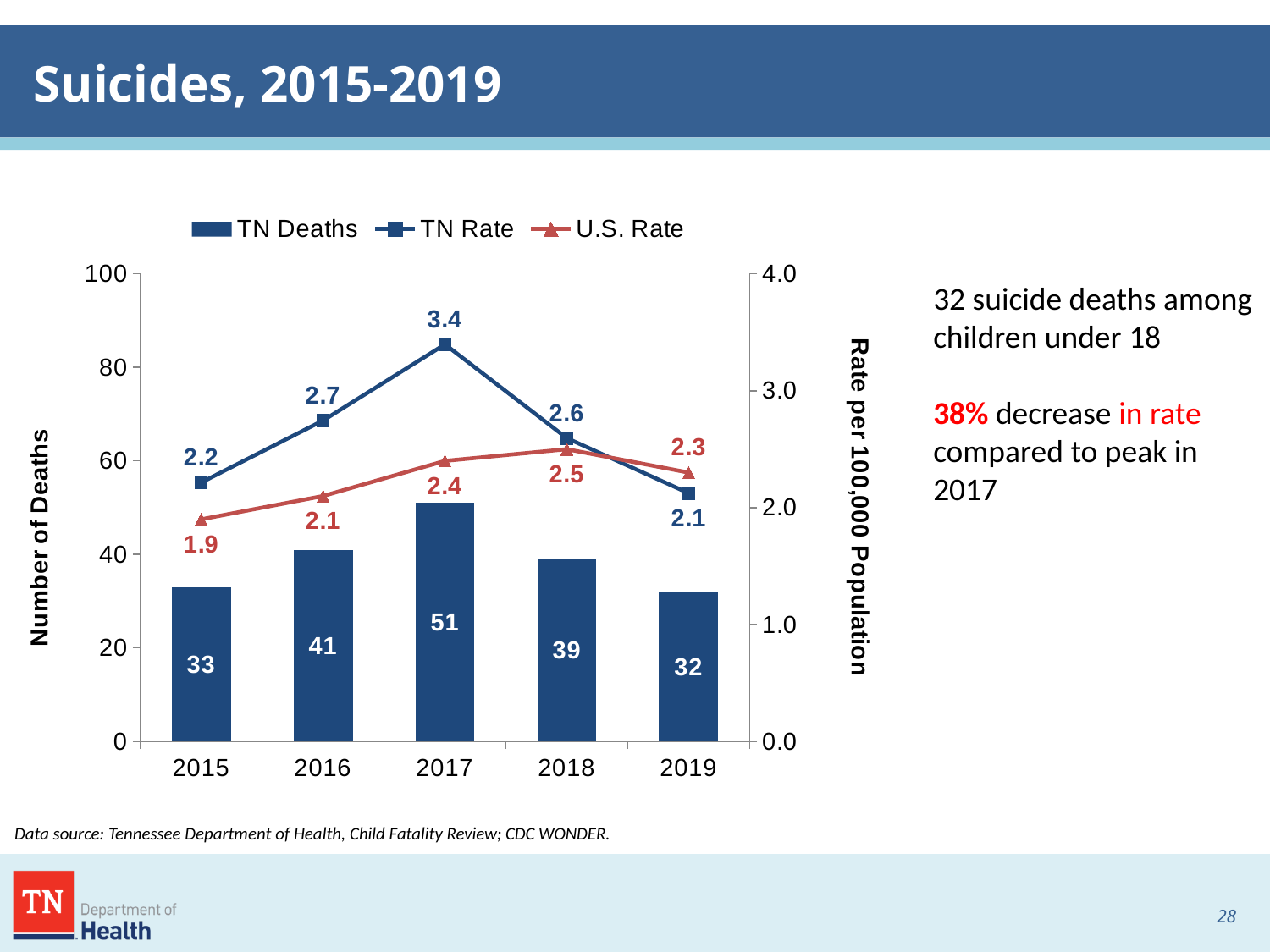
How many years are shown on the x axis? 5 Which year had the highest number of TN deaths? 2017 What was the U.S. Rate in 2019? 2.3 What was the TN Rate in 2016? 2.7 Did the TN Rate rise or fall from 2017 to 2019? fall How many TN deaths were there in 2017? 51 How many series does the legend list? 3 What is the difference between the TN Rate and the U.S. Rate in 2017? 1.0 What is the difference in TN deaths between 2017 and 2019? 19 Which was higher in 2019, the TN Rate or the U.S. Rate? U.S. Rate Which year had the lowest U.S. Rate? 2015 Which year had the lowest number of TN deaths? 2019